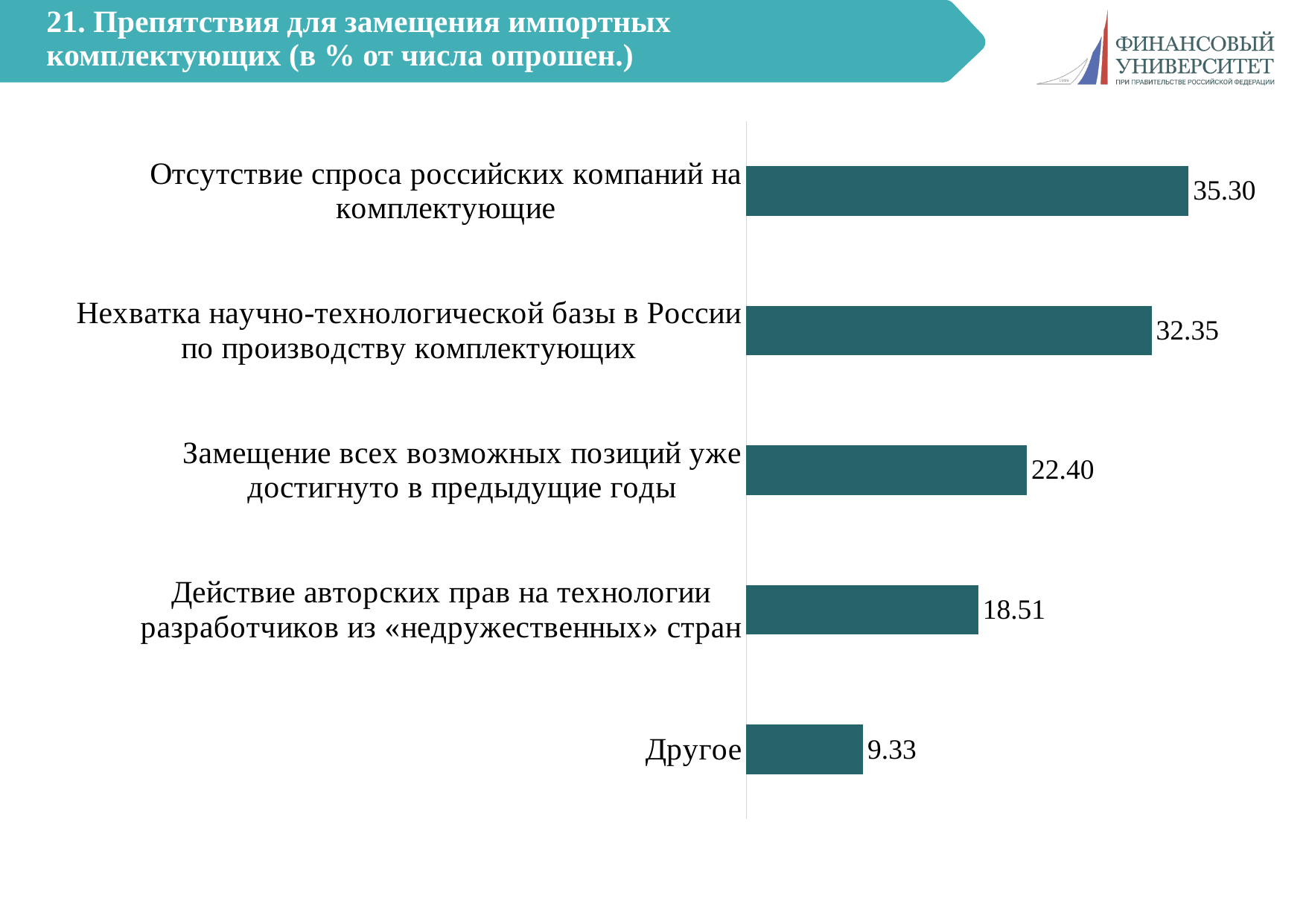
What is the value for «Другое»? 9.33 What is the value for «Замещение всех возможных позиций уже достигнуто в предыдущие годы»? 22.40 What is the value for «Действие авторских прав на технологии разработчиков из «недружественных» стран»? 18.51 Which category has the lowest value? Другое Which is larger: the value for «Замещение всех возможных позиций уже достигнуто в предыдущие годы» or for «Действие авторских прав на технологии разработчиков из «недружественных» стран»? Замещение всех возможных позиций уже достигнуто в предыдущие годы What is the difference between the values for «Отсутствие спроса российских компаний на комплектующие» and «Нехватка научно-технологической базы в России по производству комплектующих»? 2.95 What is the difference between the values for «Замещение всех возможных позиций уже достигнуто в предыдущие годы» and «Другое»? 13.07 How many categories are shown in the chart? 5 What is the value for «Нехватка научно-технологической базы в России по производству комплектующих»? 32.35 What kind of chart is shown on the slide? Bar chart What is the value for «Отсутствие спроса российских компаний на комплектующие»? 35.30 Which category has the highest value? Отсутствие спроса российских компаний на комплектующие